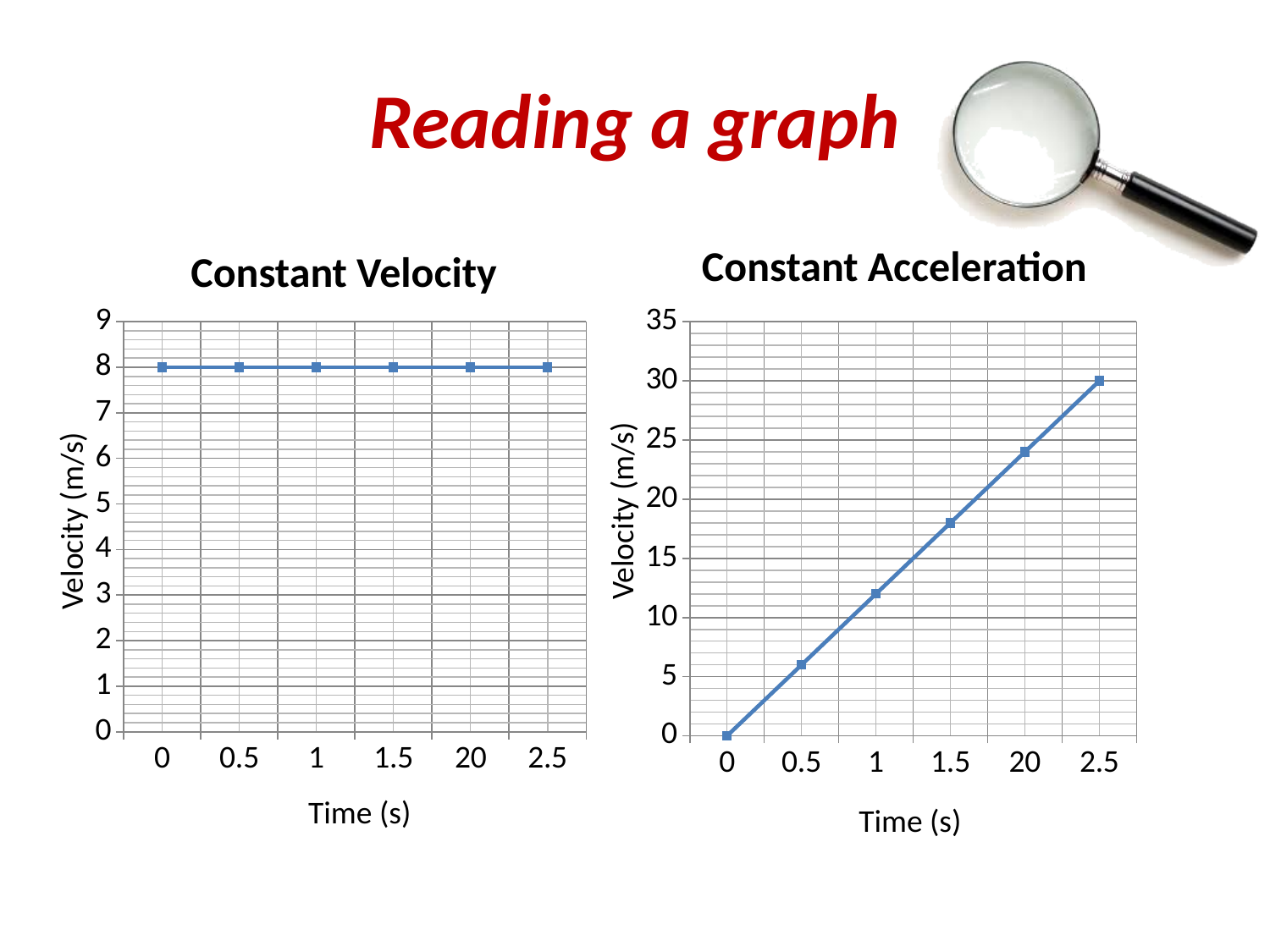
In the Constant Acceleration chart, do the values rise or fall as time increases? rise In the Constant Velocity chart, do the values rise, fall, or stay flat as time increases? stay flat In the Constant Acceleration chart, at which time is the velocity highest? 2.5 In the Constant Acceleration chart, how many data points are plotted? 6 In the Constant Acceleration chart, what is the velocity at time 2.5 s? 30 In the Constant Velocity chart, what is the velocity at time 1 s? 8 In the Constant Acceleration chart, is the velocity at time 1 s greater or less than 10? greater What is the y-axis label of the Constant Acceleration chart? Velocity (m/s) In the Constant Acceleration chart, is the velocity at time 1.5 s greater or less than 20? less In the Constant Acceleration chart, what is the velocity at time 0 s? 0 What type of chart is the Constant Velocity chart? line chart In the Constant Velocity chart, how many data points are plotted? 6